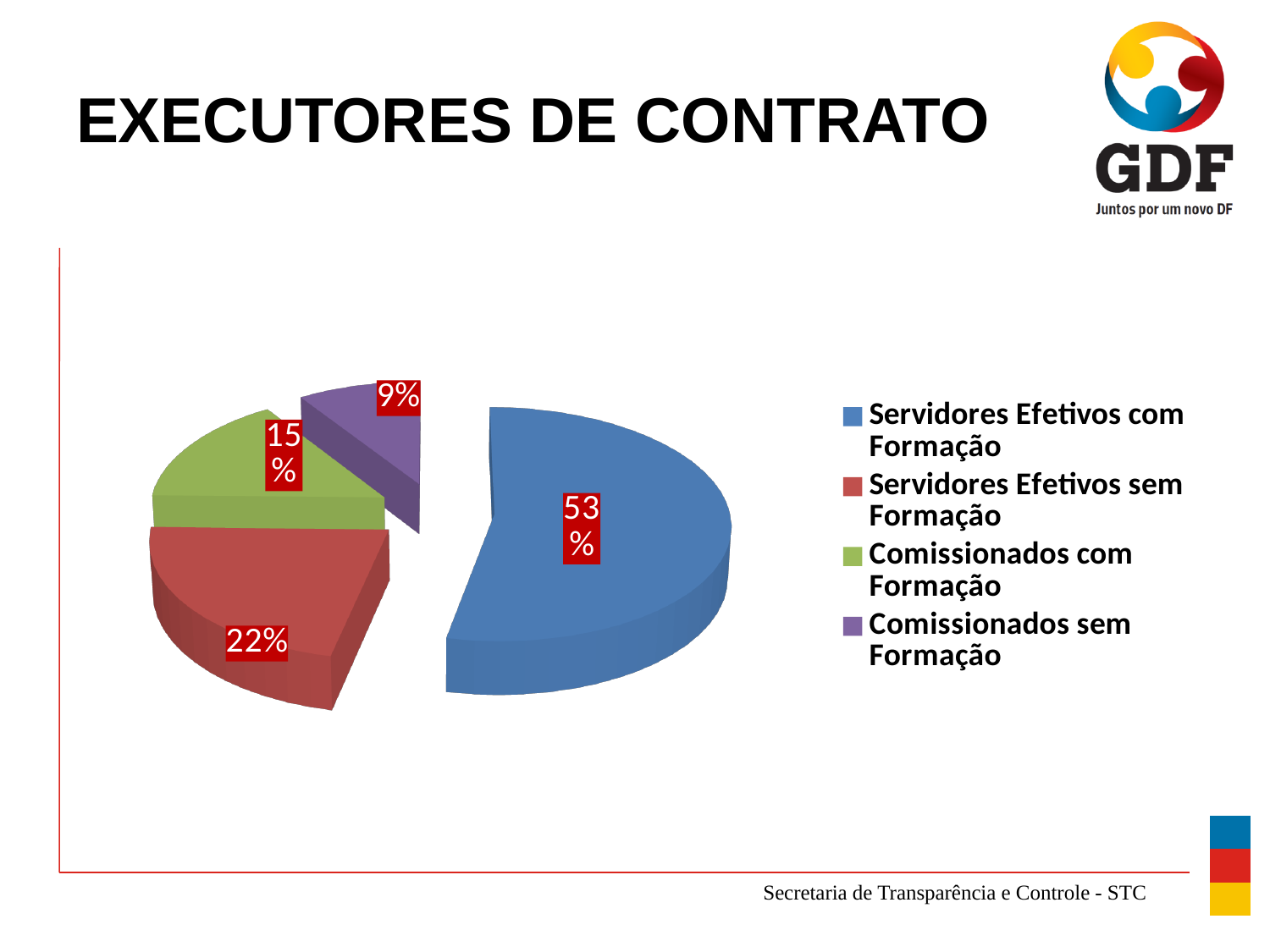
Which category has the largest slice of the pie? Servidores Efetivos com Formação What is the value shown for Comissionados sem Formação? 9% Which category has the smallest slice of the pie? Comissionados sem Formação What share of the pie does Servidores Efetivos com Formação represent? 53% What kind of chart is shown on the slide? pie chart Which colour represents Comissionados sem Formação in the pie chart? purple What is the value shown for Servidores Efetivos sem Formação? 22% How many slices does the pie chart have? 4 What is the value shown for Comissionados com Formação? 15% What is the title of the slide containing the pie chart? EXECUTORES DE CONTRATO Which is larger, the share for Comissionados com Formação or the share for Comissionados sem Formação? Comissionados com Formação What is the difference between the shares of Servidores Efetivos com Formação and Servidores Efetivos sem Formação? 31%